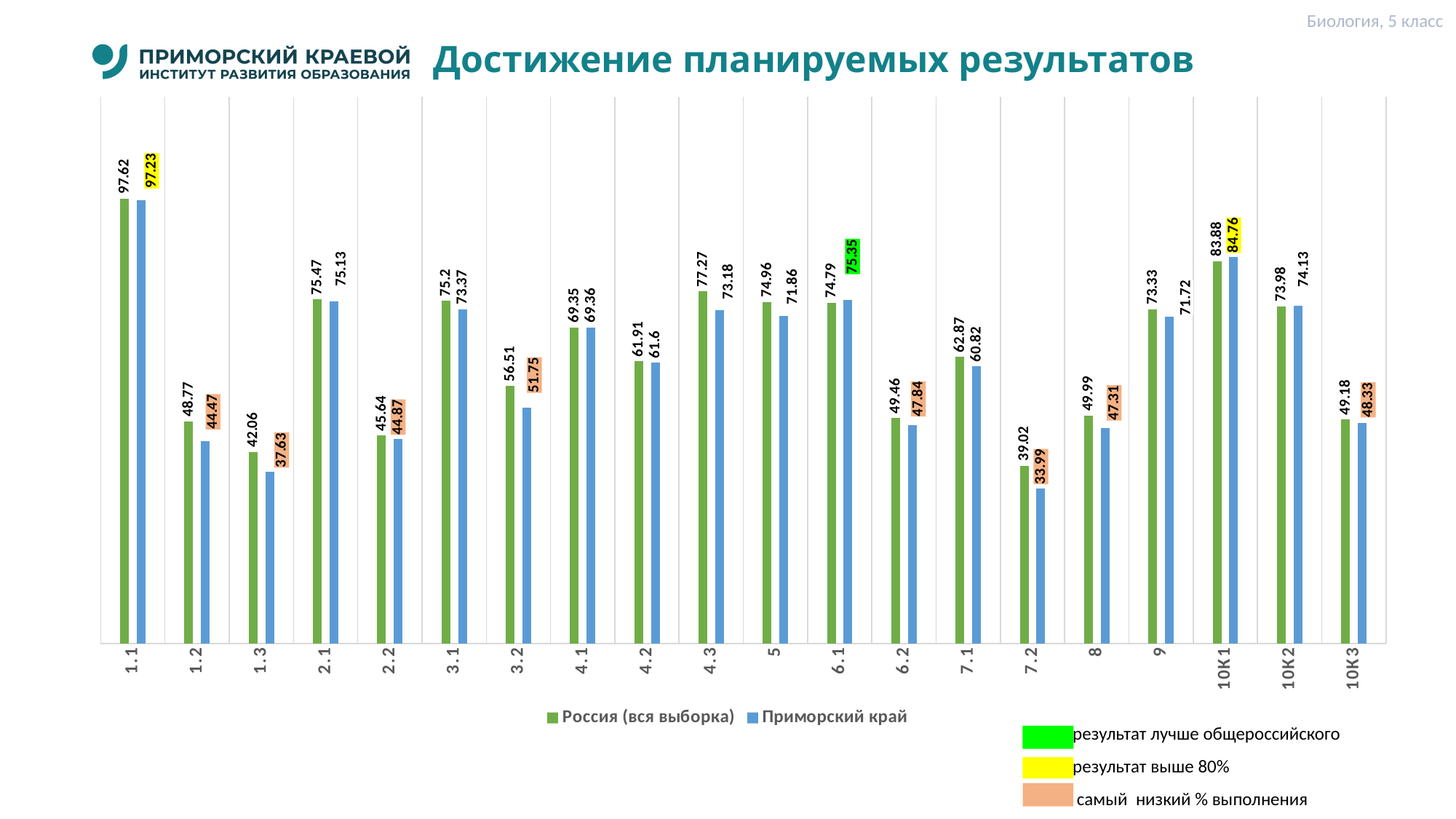
Which category has the lowest value for Приморский край? 7.2 What type of chart is shown on the slide? bar chart Which category has the highest value for Приморский край? 1.1 Which is larger in category 3.2: the value for Россия (вся выборка) or for Приморский край? Россия (вся выборка) What is the difference between the Россия (вся выборка) and Приморский край values in category 1.3? 4.43 Which is larger in category 6.1: the value for Россия (вся выборка) or for Приморский край? Приморский край How many categories are shown on the x axis of the chart? 20 What is the value for Приморский край in category 10К1? 84.76 What is the title of the chart on the slide? Достижение планируемых результатов How many series does the chart legend list? 2 What is the value for Россия (вся выборка) in category 4.3? 77.27 What is the value for Приморский край in category 7.2? 33.99